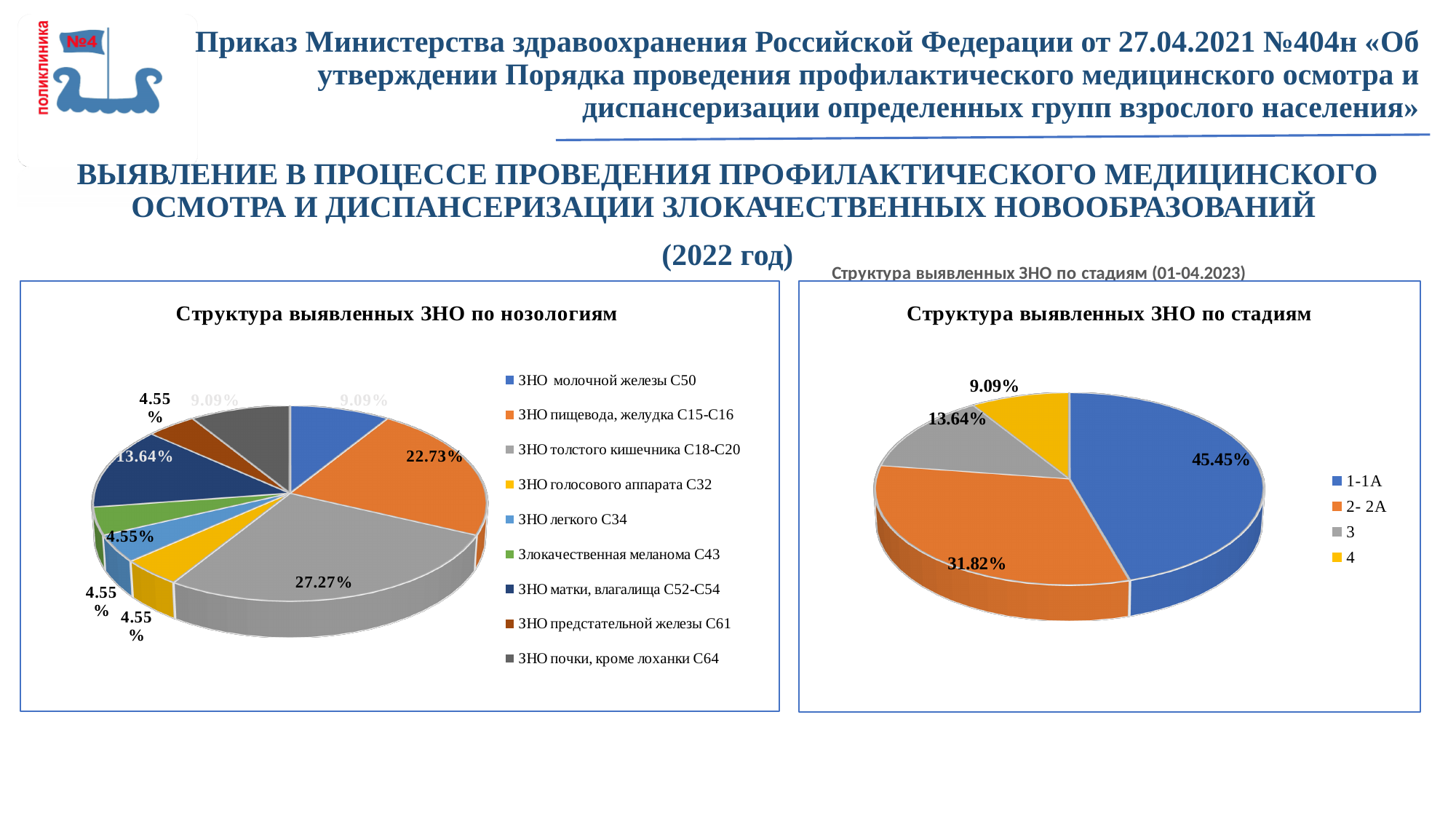
On the chart "Структура выявленных ЗНО по стадиям", what is the difference between the shares of stage 1-1A and stage 2- 2A? 13.63% On the chart "Структура выявленных ЗНО по стадиям", how many stages are shown in the legend? 4 On the chart "Структура выявленных ЗНО по стадиям", which stage has the smallest share? 4 On the chart "Структура выявленных ЗНО по нозологиям", what is the share for ЗНО пищевода, желудка C15-C16? 22.73% On the chart "Структура выявленных ЗНО по нозологиям", which category has the largest share? ЗНО толстого кишечника C18-C20 What type of chart is "Структура выявленных ЗНО по нозологиям"? Pie chart On the chart "Структура выявленных ЗНО по стадиям", what is the share for stage 4? 9.09% On the chart "Структура выявленных ЗНО по нозологиям", what is the share for ЗНО толстого кишечника C18-C20? 27.27% On the chart "Структура выявленных ЗНО по стадиям", which stage has the largest share? 1-1A On the chart "Структура выявленных ЗНО по стадиям", what is the share for stage 2- 2A? 31.82% On the chart "Структура выявленных ЗНО по нозологиям", what is the share for ЗНО матки, влагалища C52-C54? 13.64% On the chart "Структура выявленных ЗНО по стадиям", what is the share for stage 1-1A? 45.45%